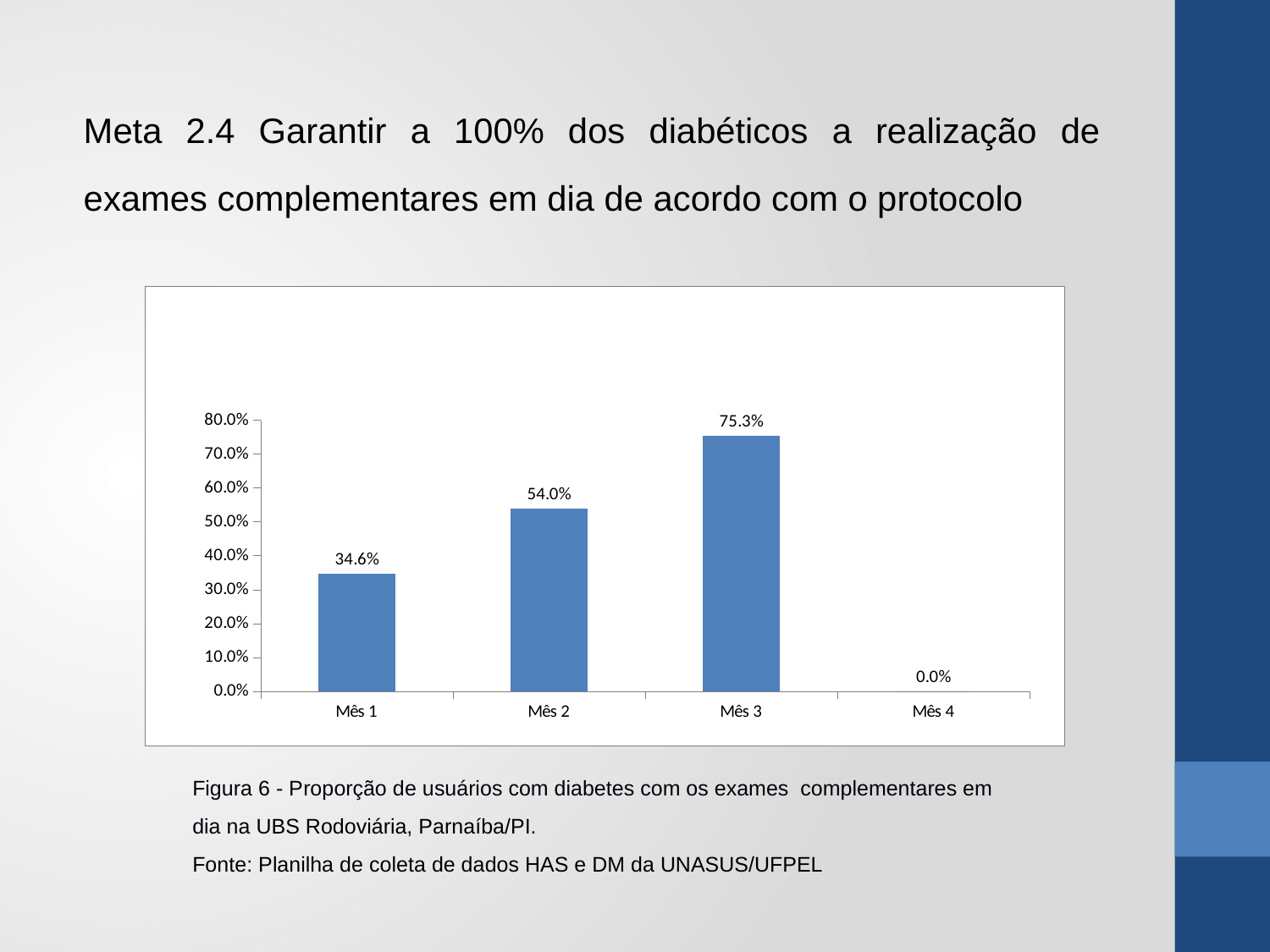
What is the value for Mês 4? 0.0% Which month has the lowest value? Mês 4 What is the value for Mês 3? 75.3% Which is larger, the value for Mês 2 or the value for Mês 3? Mês 3 Which month has the highest value? Mês 3 What is the difference between the values for Mês 3 and Mês 1? 40.7% What kind of chart is shown on the slide? Bar chart What is the value for Mês 1? 34.6% How many months are shown on the x axis? 4 What is the value for Mês 2? 54.0% What is the difference between the values for Mês 2 and Mês 1? 19.4% Do the values rise or fall from Mês 1 to Mês 3? Rise